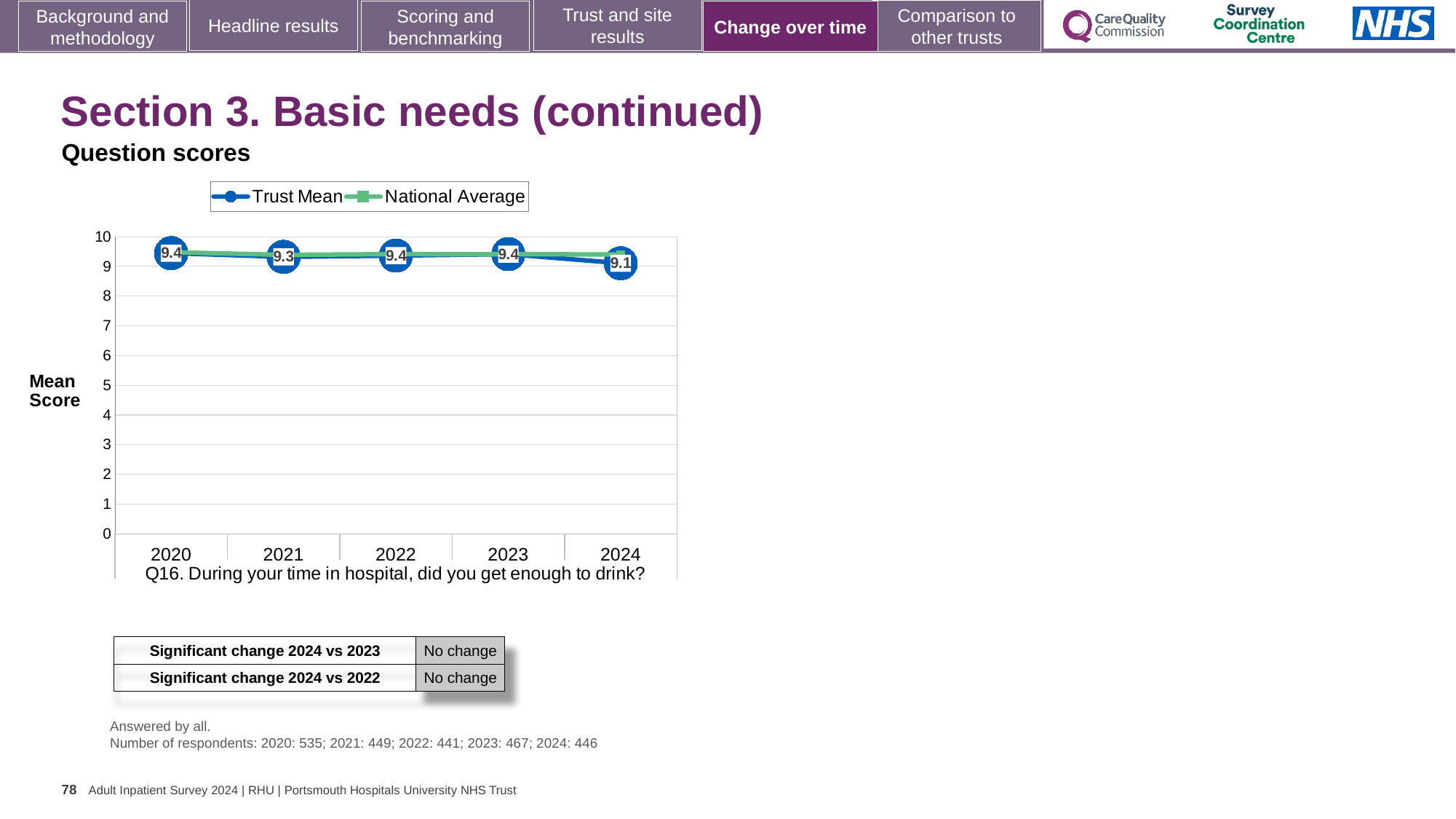
Which year has the larger Trust Mean score, 2021 or 2024? 2021 How many years are plotted on the x axis? 5 In which year is the Trust Mean score lowest? 2024 Which survey question does the chart relate to? Q16. During your time in hospital, did you get enough to drink? What is the Trust Mean score for 2024? 9.1 What is the Trust Mean score for 2020? 9.4 Does the Trust Mean score rise or fall from 2020 to 2024? Fall What is the difference between the Trust Mean scores for 2023 and 2024? 0.3 What kind of chart is shown on the slide? Line chart How many series does the legend list? 2 What is the Trust Mean score for 2021? 9.3 Is the National Average value for 2024 greater or less than 9? greater